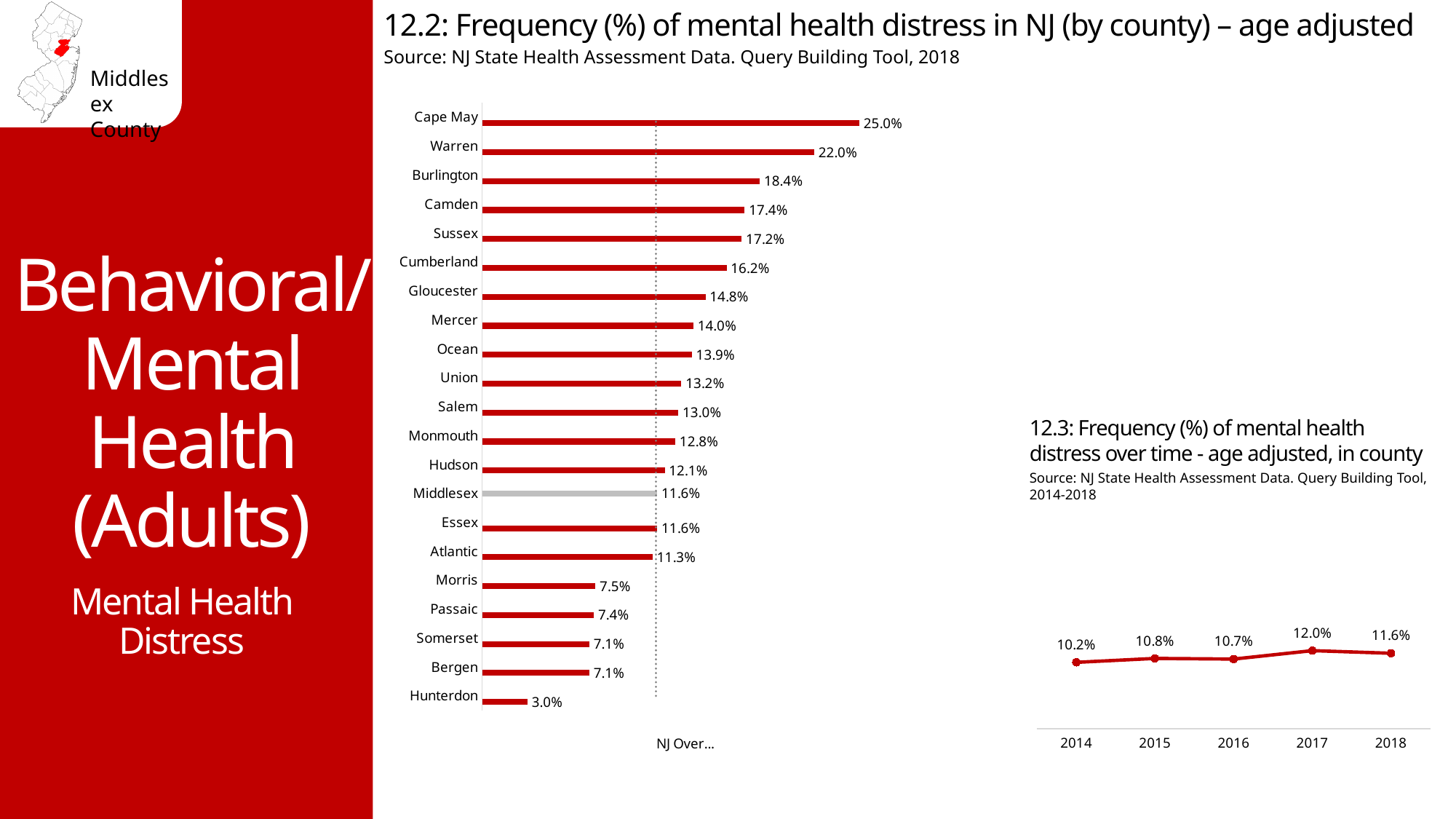
In chart 12.2 (frequency of mental health distress by county), what is the difference between Cape May and Warren? 3.0% In chart 12.2 (frequency of mental health distress by county), which is larger, the value for Camden or the value for Mercer? Camden In chart 12.2 (frequency of mental health distress by county), which county has the highest value? Cape May In chart 12.2 (frequency of mental health distress by county), how many counties are shown? 21 In chart 12.3 (mental health distress over time in county), which year has the lowest value? 2014 What kind of chart is chart 12.2 (frequency of mental health distress by county)? Bar chart In chart 12.3 (mental health distress over time in county), what is the value for 2017? 12.0% In chart 12.3 (mental health distress over time in county), what is the difference between the 2017 and 2018 values? 0.4% In chart 12.3 (mental health distress over time in county), how many years are plotted? 5 In chart 12.2 (frequency of mental health distress by county), which county has the lowest value? Hunterdon In chart 12.2 (frequency of mental health distress by county), what is the value for Hunterdon? 3.0% In chart 12.2 (frequency of mental health distress by county), what is the value for Middlesex? 11.6%